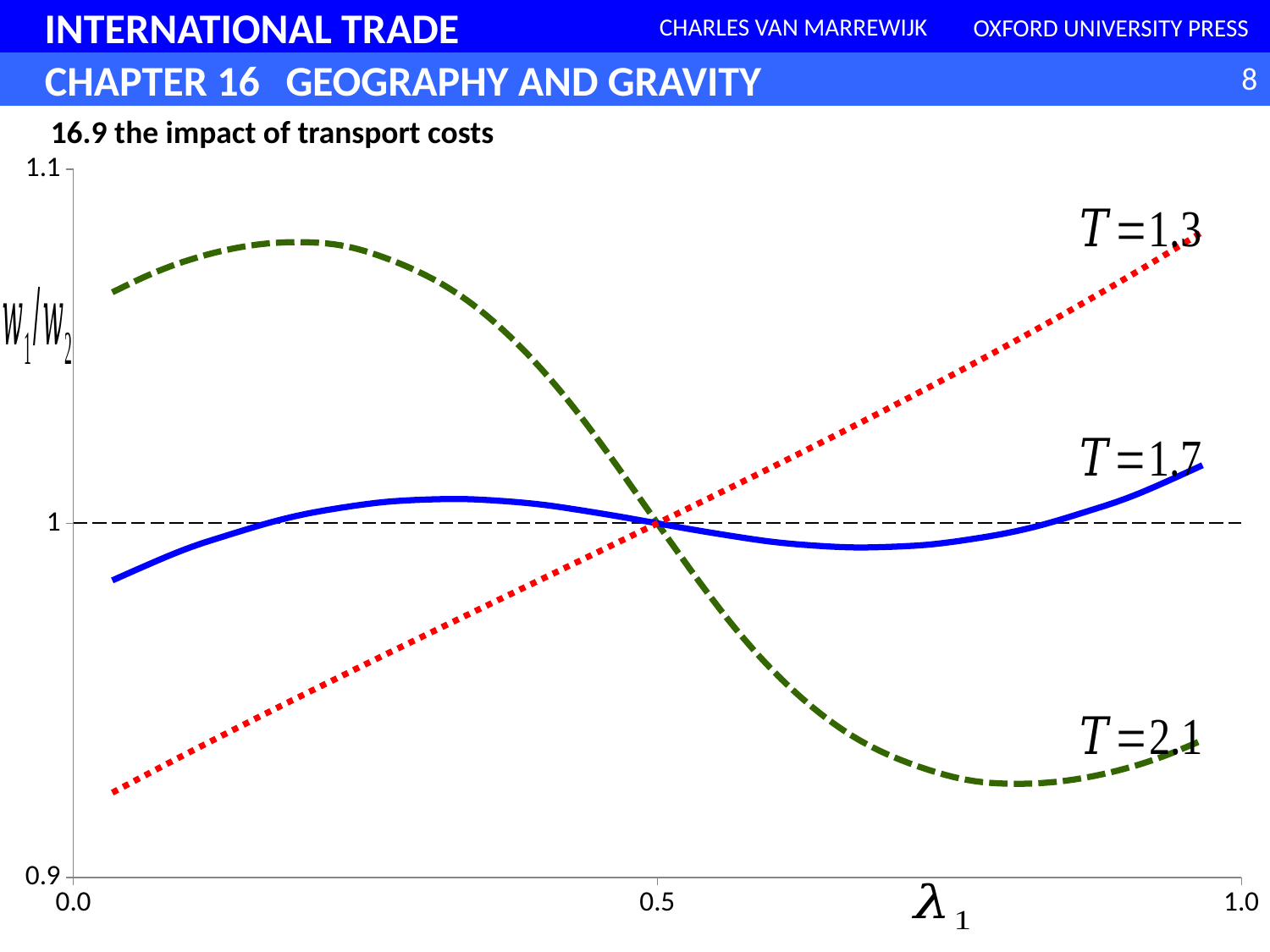
How many curves (values of T) are plotted on the chart? 3 Which curve has the lowest w1/w2 at λ1 = 0.9? T=2.1 What is the title of the chart? 16.9 the impact of transport costs Is the value of the T=2.1 curve at λ1 = 0.9 greater or less than 1? less What variable is shown on the vertical axis? w1/w2 Which curve has the highest w1/w2 at λ1 = 0.1? T=2.1 Is the value of the T=2.1 curve at λ1 = 0.1 greater or less than 1? greater At λ1 = 0.9, which curve is higher: T=1.3 or T=1.7? T=1.3 What kind of chart is shown on the slide? line chart Is the value of the T=1.3 curve at λ1 = 0.1 greater or less than 1? less At λ1 = 0.5, what value of w1/w2 do all three curves pass through? 1 Does the T=1.3 curve rise or fall as λ1 increases? rises